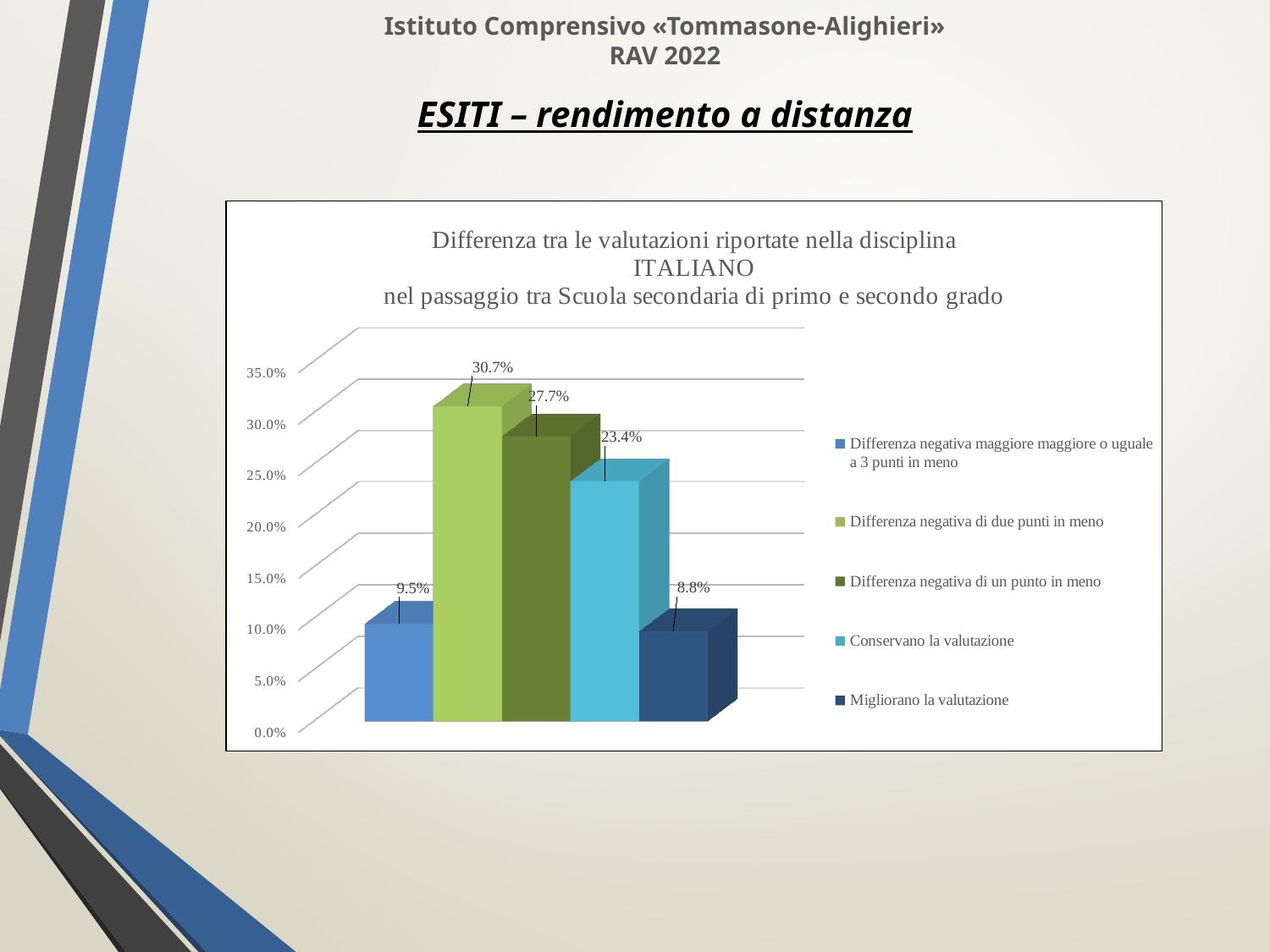
What is the difference between "Differenza negativa di due punti in meno" and "Differenza negativa di un punto in meno"? 3.0% What is the value for "Migliorano la valutazione"? 8.8% What is the value for "Differenza negativa di due punti in meno"? 30.7% What is the value for "Differenza negativa di un punto in meno"? 27.7% Which legend entry has the lowest value? Migliorano la valutazione Which is larger: "Differenza negativa maggiore maggiore o uguale a 3 punti in meno" or "Migliorano la valutazione"? Differenza negativa maggiore maggiore o uguale a 3 punti in meno What kind of chart is shown on the slide? Bar chart How many entries does the legend list? 5 What is the value for "Conservano la valutazione"? 23.4% What is the difference between "Conservano la valutazione" and "Migliorano la valutazione"? 14.6% Is the value for "Conservano la valutazione" greater or less than 20.0%? greater Which legend entry has the highest value? Differenza negativa di due punti in meno